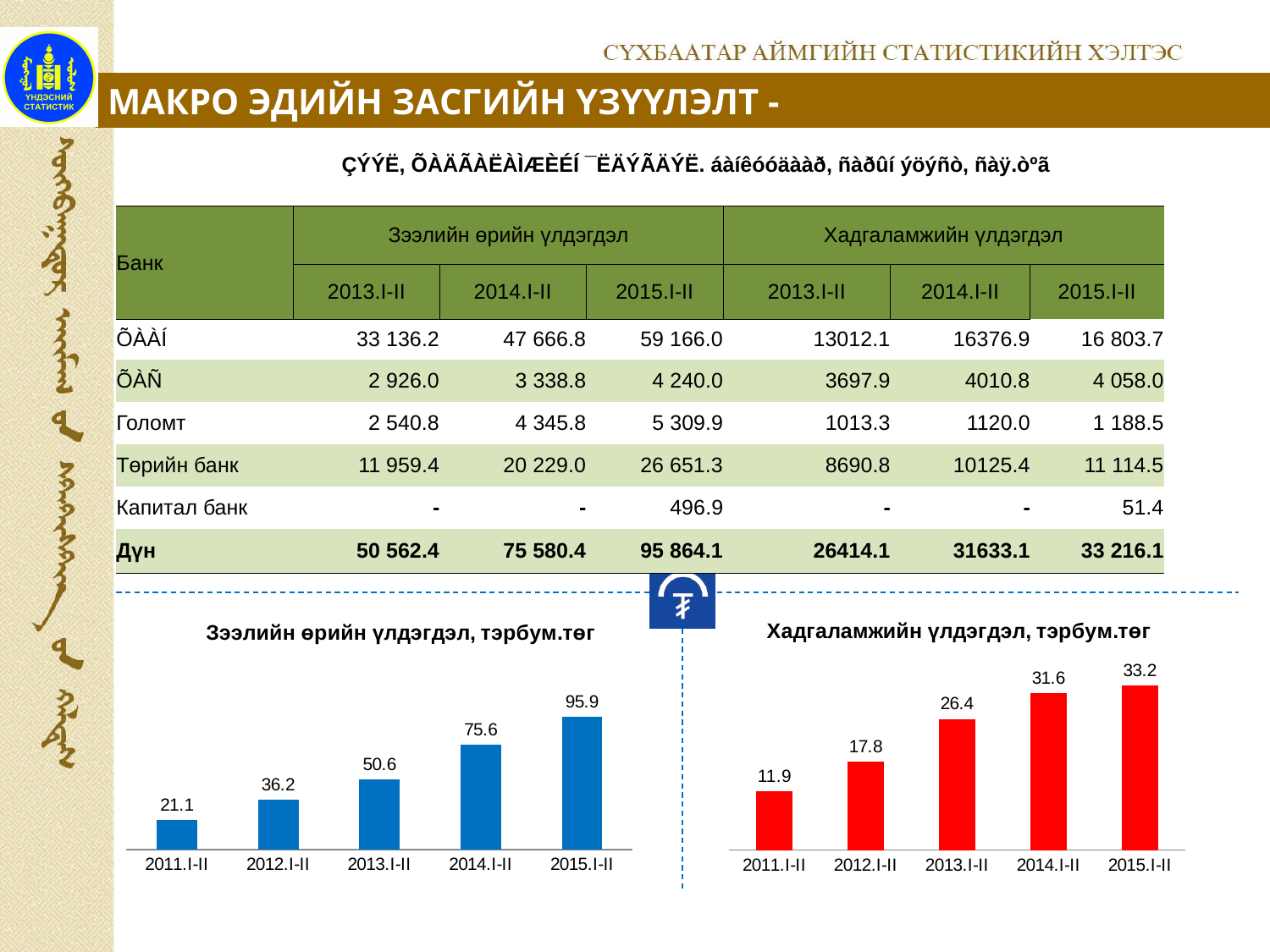
In the chart titled "Зээлийн өрийн үлдэгдэл, тэрбум.төг", what is the value for 2011.I-II? 21.1 In the chart titled "Хадгаламжийн үлдэгдэл, тэрбум.төг", what is the difference between the values for 2013.I-II and 2011.I-II? 14.5 In the chart titled "Зээлийн өрийн үлдэгдэл, тэрбум.төг", what is the difference between the values for 2015.I-II and 2014.I-II? 20.3 In the chart titled "Хадгаламжийн үлдэгдэл, тэрбум.төг", what is the value for 2012.I-II? 17.8 In the chart titled "Зээлийн өрийн үлдэгдэл, тэрбум.төг", what is the value for 2013.I-II? 50.6 What colour are the bars in the chart titled "Хадгаламжийн үлдэгдэл, тэрбум.төг"? Red How many periods are shown on the x axis of the chart titled "Хадгаламжийн үлдэгдэл, тэрбум.төг"? 5 In the chart titled "Зээлийн өрийн үлдэгдэл, тэрбум.төг", which period has the highest value? 2015.I-II What kind of chart is the chart titled "Зээлийн өрийн үлдэгдэл, тэрбум.төг"? Bar chart In the chart titled "Зээлийн өрийн үлдэгдэл, тэрбум.төг", which is larger: the value for 2012.I-II or 2013.I-II? 2013.I-II In the chart titled "Хадгаламжийн үлдэгдэл, тэрбум.төг", do the values rise or fall from 2011.I-II to 2015.I-II? Rise In the chart titled "Хадгаламжийн үлдэгдэл, тэрбум.төг", which period has the lowest value? 2011.I-II